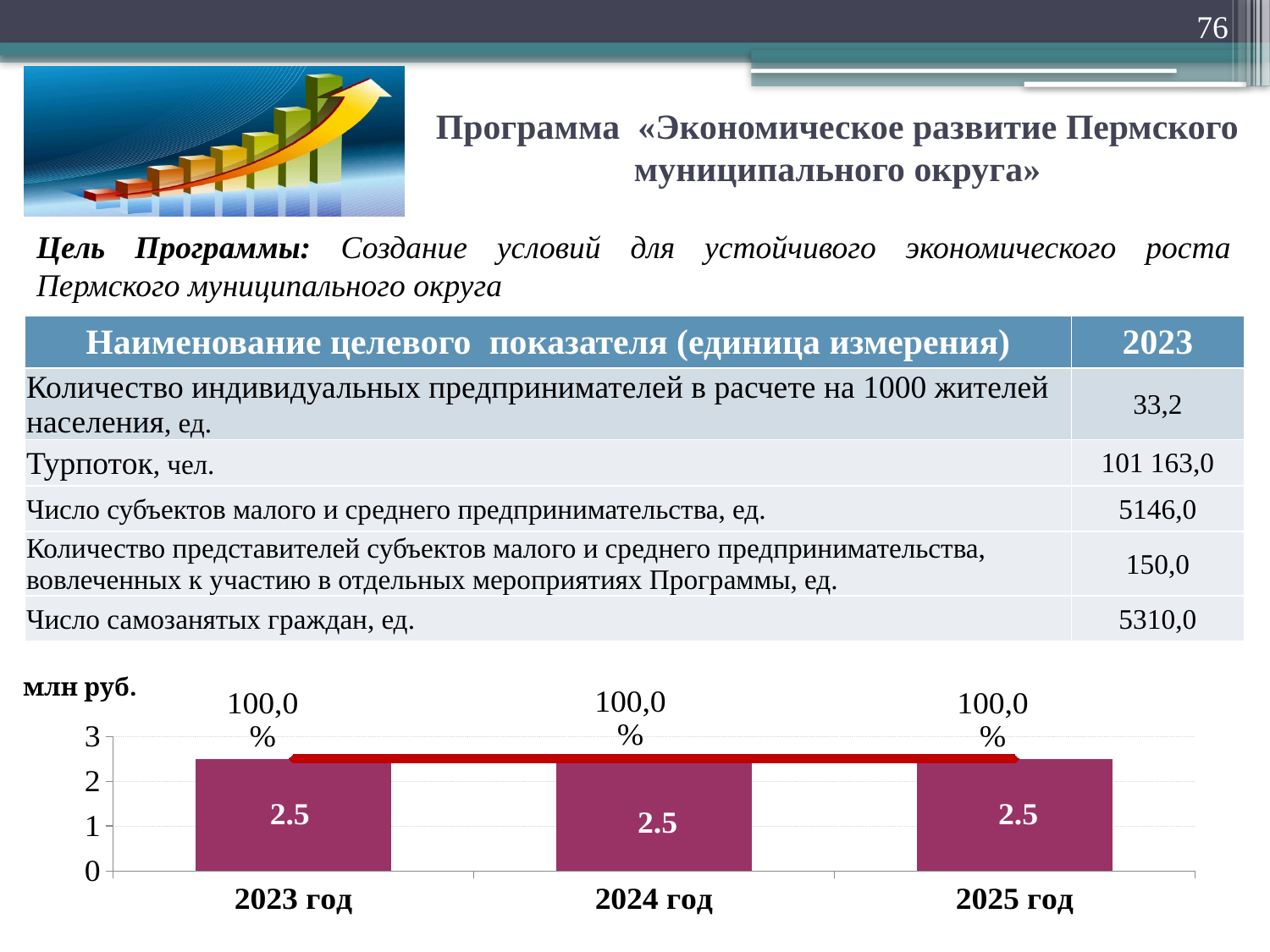
What is the value of the bar for 2025 год? 2.5 Is the value for 2023 год greater or less than 2? greater What is the value of the bar for 2023 год? 2.5 Do the bar values rise, fall or stay the same from 2023 год to 2025 год? stay the same What unit is written at the top left of the chart's vertical axis? млн руб. What kind of chart is shown at the bottom of the slide? combination bar and line chart What is the difference between the bar values for 2023 год and 2025 год? 0 How many years are shown on the x axis of the bar chart? 3 What colour are the bars in the chart? purple What percentage label is shown above the bar for 2025 год? 100,0 % What is the value of the bar for 2024 год? 2.5 Is the value for 2024 год greater or less than 3? less